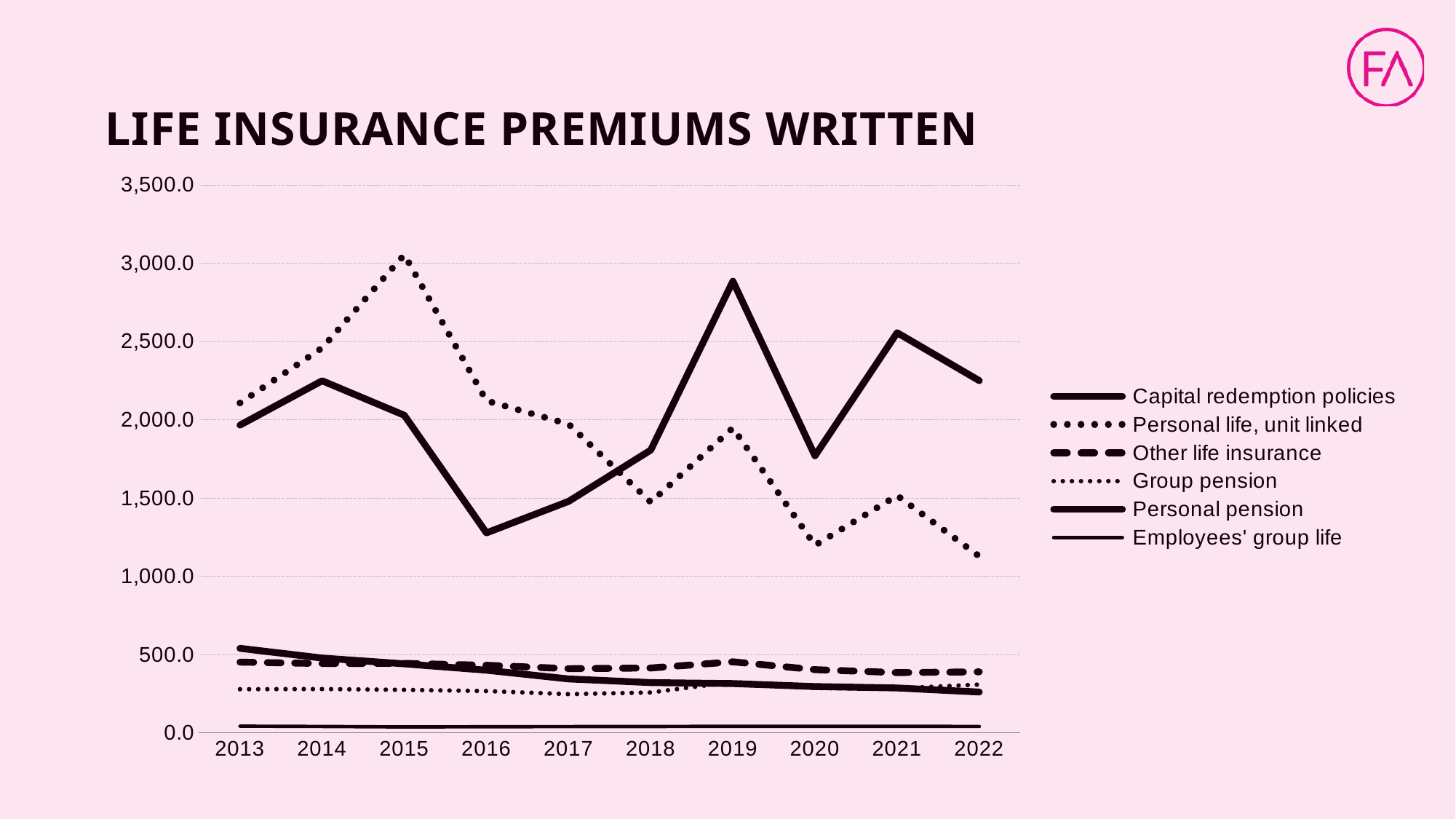
Which series has the lowest values across all years? Employees' group life Is the value for Personal life, unit linked larger in 2015 or in 2022? 2015 How many years are shown on the x axis? 10 Is the value for Personal life, unit linked in 2013 greater or less than 2,000? greater Which series has the highest value in 2015? Personal life, unit linked What is the title of the chart? LIFE INSURANCE PREMIUMS WRITTEN Is the value for Personal life, unit linked in 2022 greater or less than 1,500? less Does the Personal life, unit linked series rise or fall overall from 2015 to 2022? fall In which year does the Personal life, unit linked series reach its highest value? 2015 Is the value for Other life insurance in 2019 greater or less than 500? less What kind of chart is shown on the slide? Line chart How many series does the legend list? 6